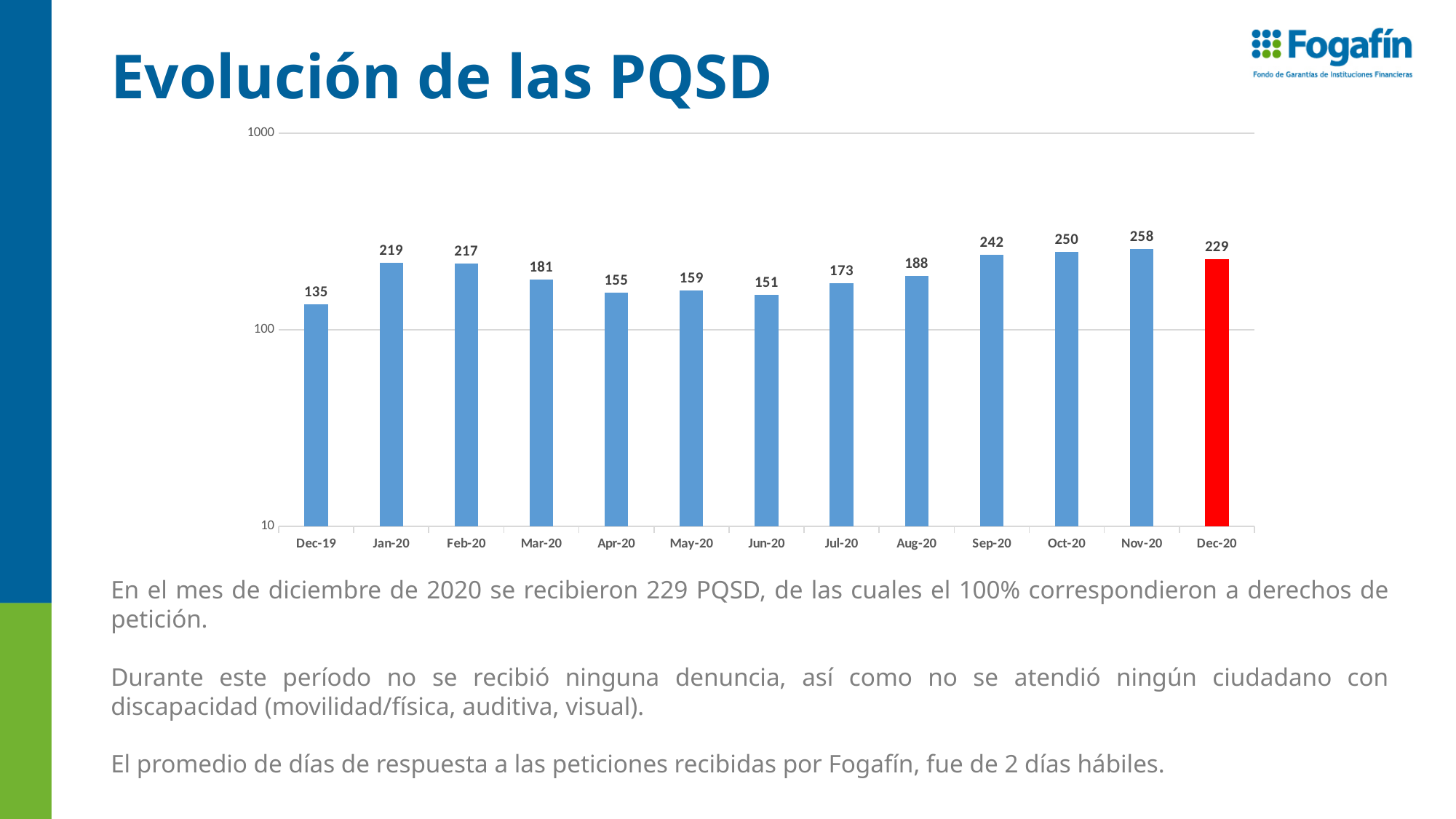
What is the difference between the values for Nov-20 and Dec-20? 29 What is the difference between the values for Jan-20 and Dec-19? 84 Which month has the lowest value? Dec-19 How many months are shown on the x axis? 13 What kind of chart is shown on the slide? bar chart What is the value for Jun-20? 151 Is the value for Sep-20 greater or less than 100? greater Which month has the highest value? Nov-20 Which is larger, the value for Jan-20 or the value for Feb-20? Jan-20 Which bar is coloured red instead of blue? Dec-20 What is the value for Mar-20? 181 What is the value for Dec-20? 229